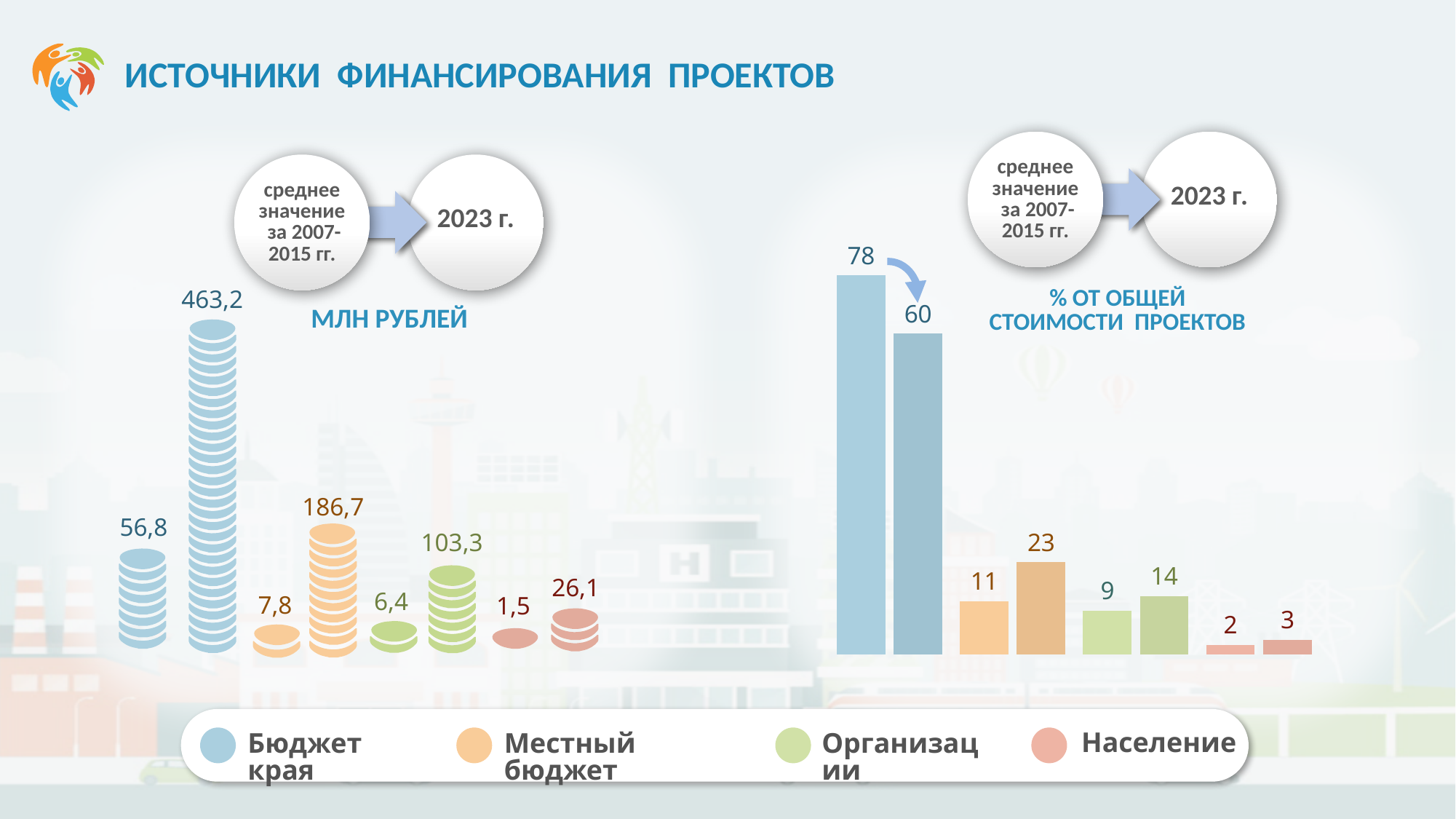
How many funding sources does the legend list? 4 In the '% ОТ ОБЩЕЙ СТОИМОСТИ ПРОЕКТОВ' chart, what is the difference between the average 2007-2015 value and the 2023 value for 'Бюджет края'? 18 In the '% ОТ ОБЩЕЙ СТОИМОСТИ ПРОЕКТОВ' chart, what is the average 2007-2015 value for 'Организации'? 9 In the '% ОТ ОБЩЕЙ СТОИМОСТИ ПРОЕКТОВ' chart, which source has the lowest average 2007-2015 value? Население In the 'МЛН РУБЛЕЙ' chart, what is the average 2007-2015 value for 'Местный бюджет'? 7,8 In the 'МЛН РУБЛЕЙ' chart, what is the 2023 value for 'Бюджет края'? 463,2 What type of chart is the '% ОТ ОБЩЕЙ СТОИМОСТИ ПРОЕКТОВ' chart? Bar chart In the 'МЛН РУБЛЕЙ' chart, what is the difference between the 2023 value and the average 2007-2015 value for 'Организации'? 96,9 In the 'МЛН РУБЛЕЙ' chart, which source has the highest 2023 value? Бюджет края In the 'МЛН РУБЛЕЙ' chart, what is the 2023 value for 'Население'? 26,1 In the '% ОТ ОБЩЕЙ СТОИМОСТИ ПРОЕКТОВ' chart, what is the 2023 value for 'Бюджет края'? 60 In the '% ОТ ОБЩЕЙ СТОИМОСТИ ПРОЕКТОВ' chart, which is larger for 'Местный бюджет': the average 2007-2015 value or the 2023 value? 2023 value